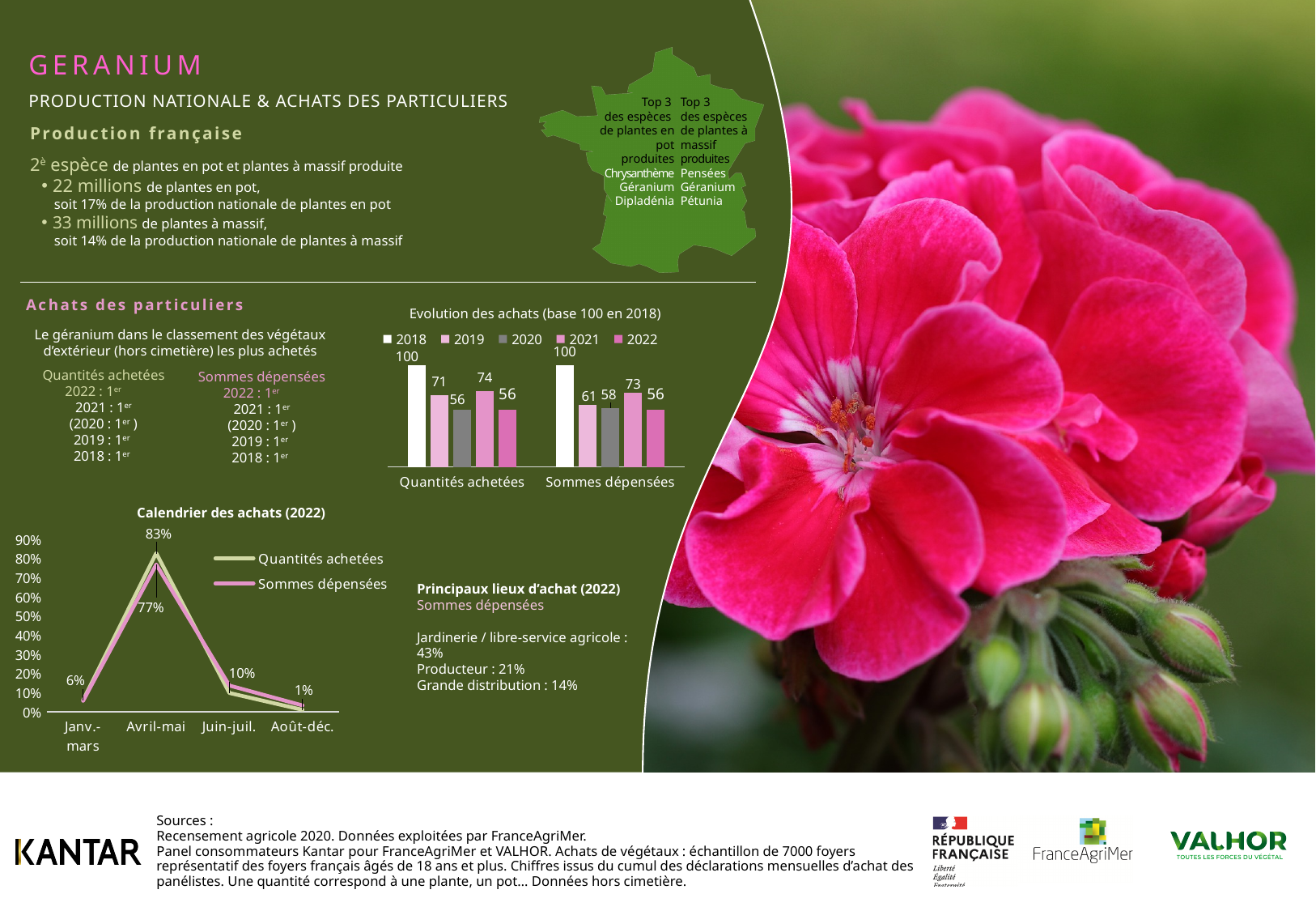
How many series does the legend of the 'Evolution des achats (base 100 en 2018)' chart list? 5 In the 'Calendrier des achats (2022)' chart, do the values rise or fall from Avril-mai to Août-déc.? Fall In the 'Calendrier des achats (2022)' chart, which period has the highest values? Avril-mai How many periods are shown on the x axis of the 'Calendrier des achats (2022)' chart? 4 In the 'Evolution des achats (base 100 en 2018)' chart, what is the value for 2020 in the 'Sommes dépensées' group? 58 In the 'Evolution des achats (base 100 en 2018)' chart, what is the difference between the 2018 and 2019 values in the 'Quantités achetées' group? 29 In the 'Evolution des achats (base 100 en 2018)' chart, which year has the lowest value in the 'Quantités achetées' group? 2020 and 2022 (both 56) In the 'Evolution des achats (base 100 en 2018)' chart, what is the value for 2021 in the 'Quantités achetées' group? 74 In the 'Evolution des achats (base 100 en 2018)' chart, what is the value for 2019 in the 'Sommes dépensées' group? 61 In the 'Evolution des achats (base 100 en 2018)' chart, which is larger in the 'Sommes dépensées' group: 2021 or 2022? 2021 What kind of chart is 'Evolution des achats (base 100 en 2018)'? Bar chart What kind of chart is 'Calendrier des achats (2022)'? Line chart